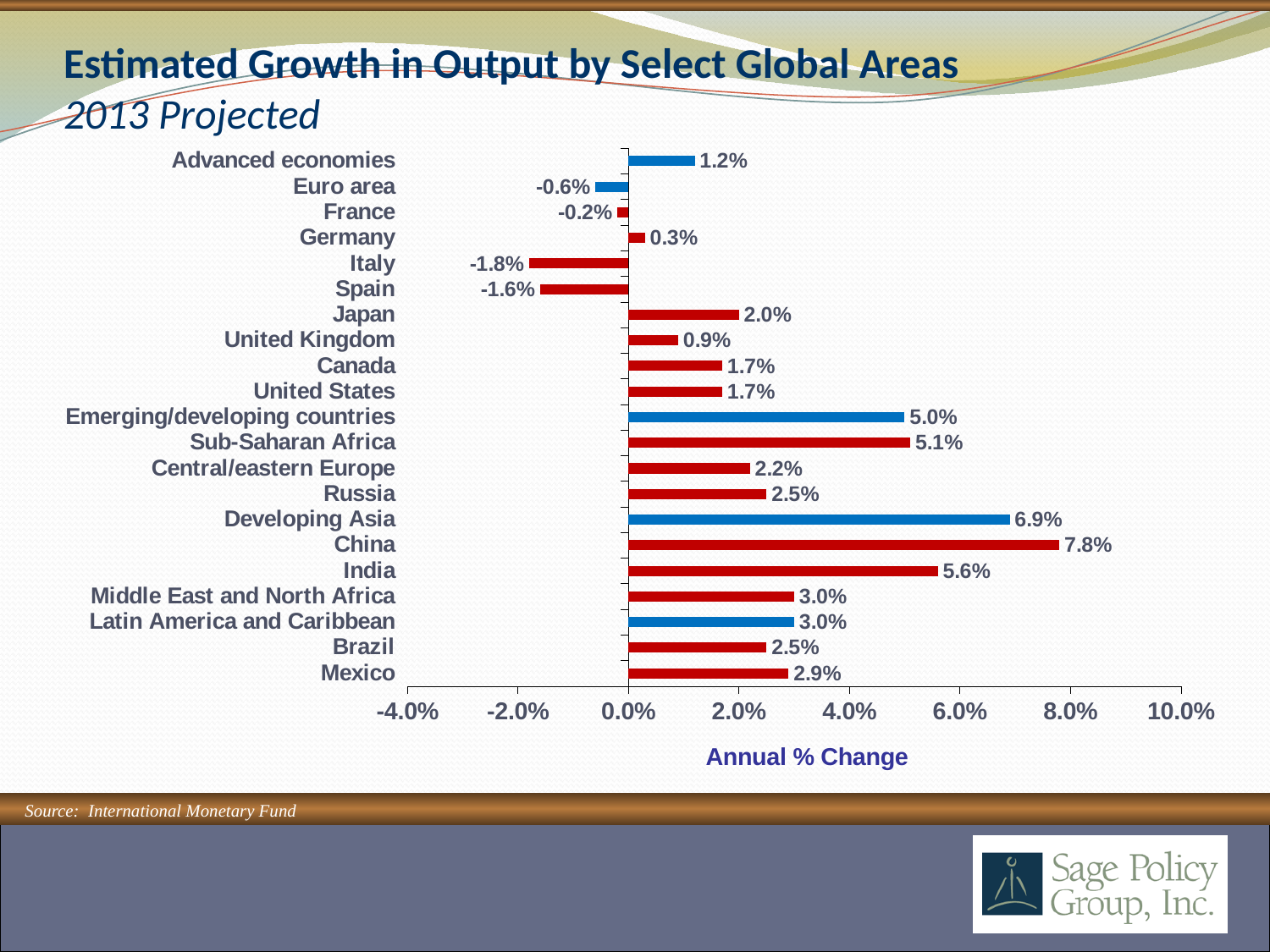
Which has a higher projected growth in output, Japan or the United Kingdom? Japan How many areas are shown in the chart? 21 What is the difference between the projected growth for Developing Asia and Advanced economies? 5.7% What is the projected 2013 growth in output for China? 7.8% What is the label of the horizontal axis? Annual % Change Which area has the highest projected growth in output? China What is the projected 2013 growth in output for the Euro area? -0.6% What type of chart is shown on the slide? Bar chart What is the projected 2013 growth in output for Sub-Saharan Africa? 5.1% Which area has the lowest projected growth in output? Italy What is the difference between the projected growth for China and India? 2.2% Which has a lower projected growth in output, Italy or Spain? Italy